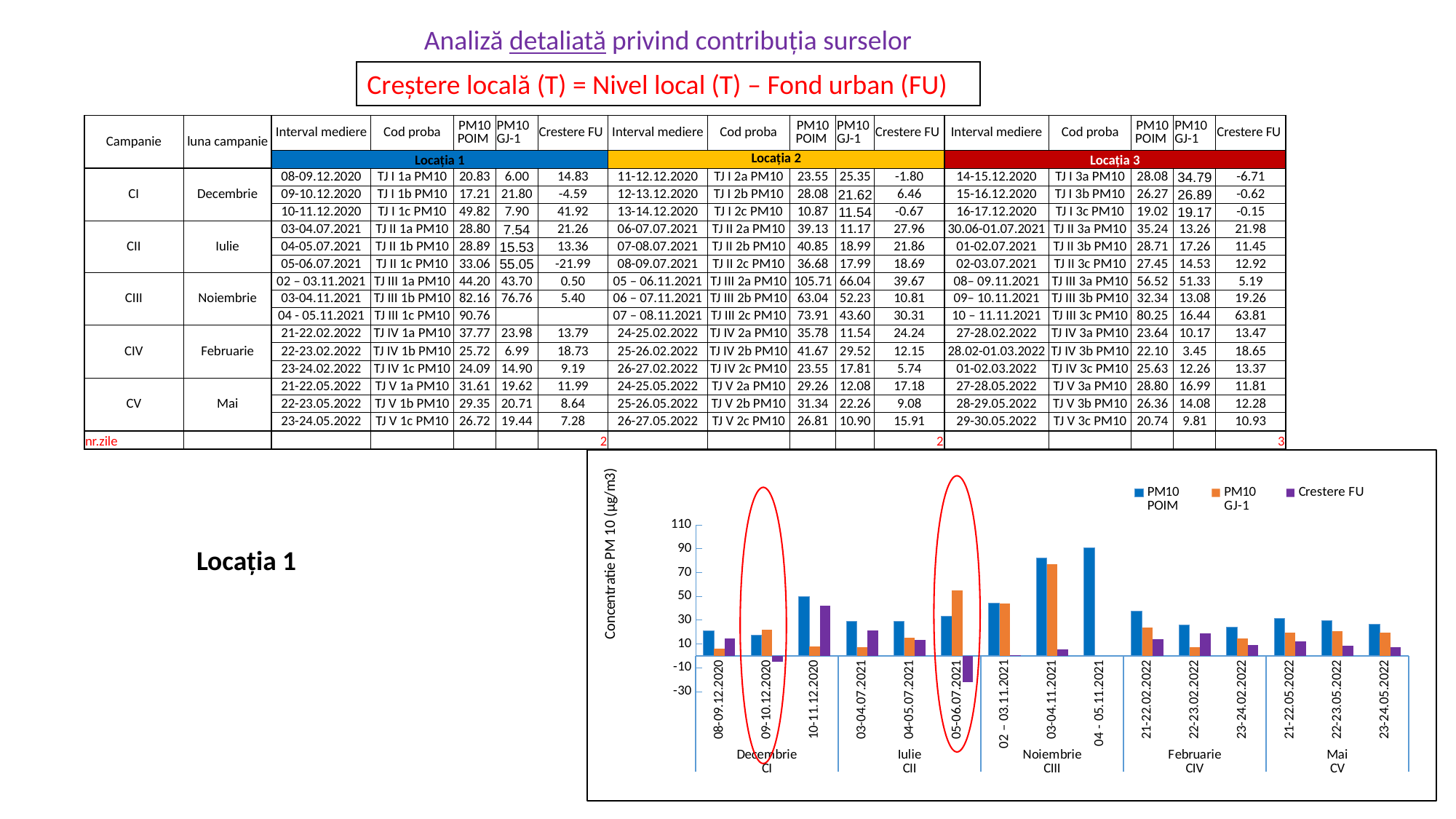
How many series does the chart legend list? 3 What kind of chart is shown on the slide? bar chart How many date categories are plotted along the x axis of the chart? 15 What is the title of the chart's vertical axis? Concentratie PM 10 (µg/m3) In the chart, is the Crestere FU value for 10-11.12.2020 greater or less than 30? greater For 10-11.12.2020, which is larger in the chart: PM10 POIM or PM10 GJ-1? PM10 POIM Which location does the chart on the slide represent? Locația 1 In the chart, is the PM10 POIM value for 03-04.11.2021 greater or less than 70? greater For 05-06.07.2021, which is larger in the chart: PM10 POIM or PM10 GJ-1? PM10 GJ-1 In the chart, is the PM10 GJ-1 value for 22-23.02.2022 greater or less than 10? less Which date has the lowest Crestere FU bar in the chart? 05-06.07.2021 Which date has the highest PM10 POIM bar in the chart? 04 - 05.11.2021